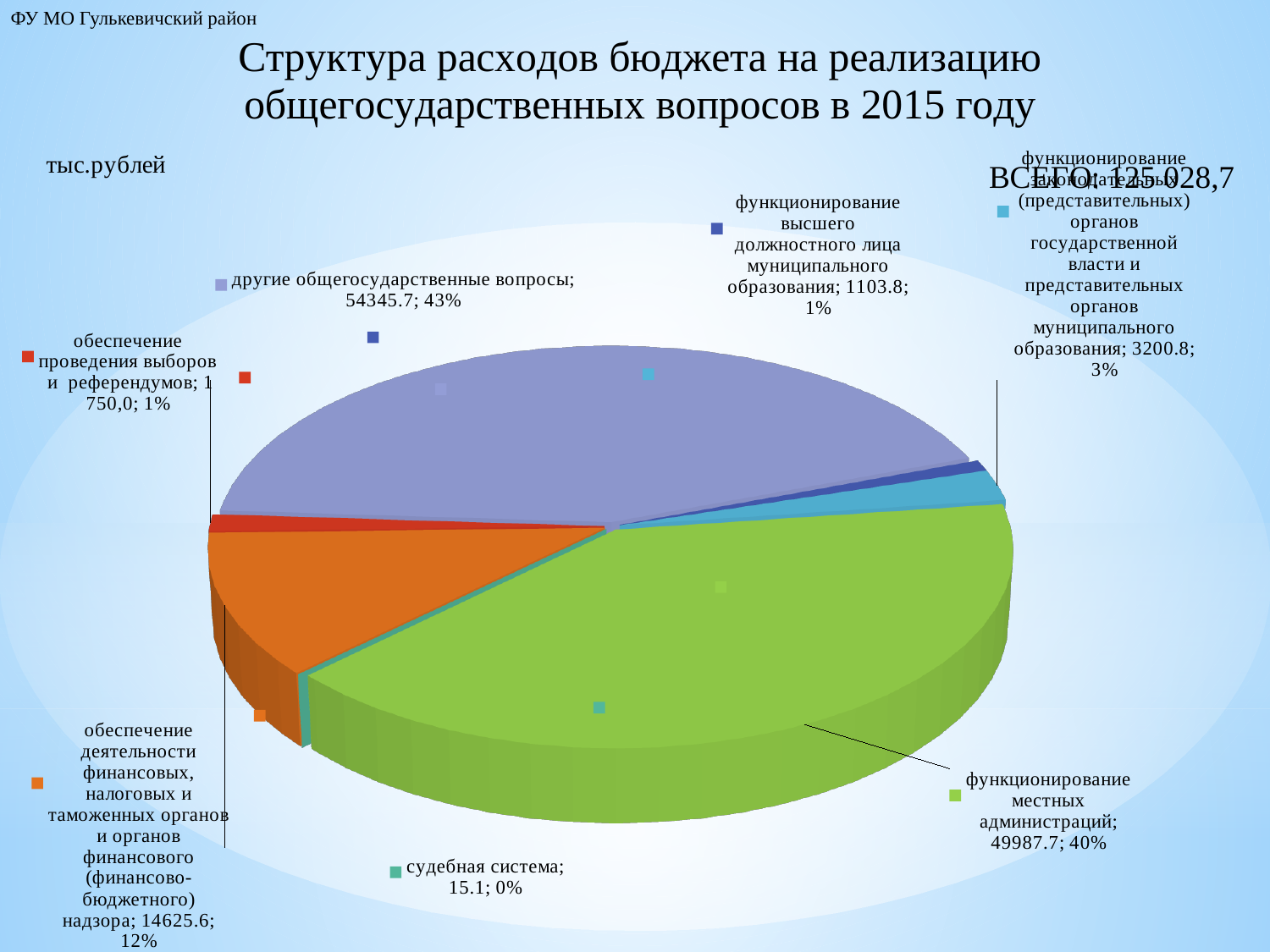
How many categories (slices) does the pie chart show? 7 What is the value for 'функционирование местных администраций'? 49987.7 What share of the pie does 'функционирование местных администраций' represent? 40% Which is larger: 'функционирование высшего должностного лица муниципального образования' or 'функционирование законодательных (представительных) органов государственной власти и представительных органов муниципального образования'? функционирование законодательных (представительных) органов государственной власти и представительных органов муниципального образования What type of chart is shown on the slide? pie chart Which category has the largest value? другие общегосударственные вопросы What is the difference between the values for 'другие общегосударственные вопросы' and 'функционирование местных администраций'? 4358.0 Which category has the smallest value? судебная система What is the value for 'функционирование законодательных (представительных) органов государственной власти и представительных органов муниципального образования'? 3200.8 What share of the pie does 'обеспечение деятельности финансовых, налоговых и таможенных органов и органов финансового (финансово-бюджетного) надзора' represent? 12% What is the value for 'другие общегосударственные вопросы'? 54345.7 What is the value for 'судебная система'? 15.1